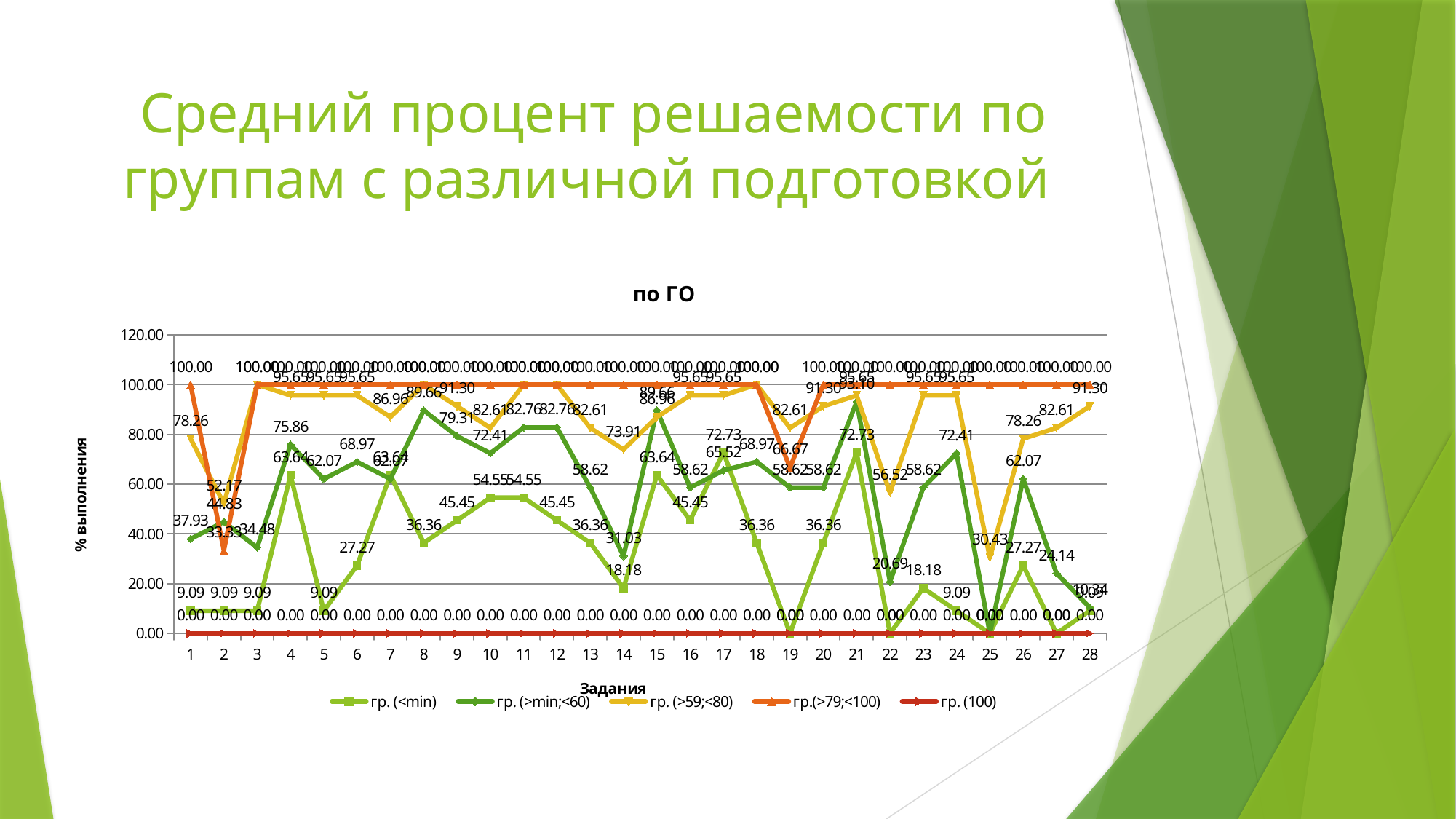
What is the title of the chart? по ГО What is the value for гр. (>min;<60) at task 22? 20.69 How many series does the legend list? 5 What kind of chart is shown on the slide? line chart At which task does гр. (>min;<60) reach its highest value? 21 How many tasks (Задания) are plotted along the x axis? 28 What is the value for гр. (<min) at task 14? 18.18 What is the value for гр.(>79;<100) at task 19? 66.67 At task 4, which is larger: гр. (>min;<60) or гр. (<min)? гр. (>min;<60) At which task does гр. (>min;<60) have its lowest value? 25 What is the difference between гр. (>min;<60) and гр. (<min) at task 14? 12.85 What is the value for гр. (>59;<80) at task 25? 30.43